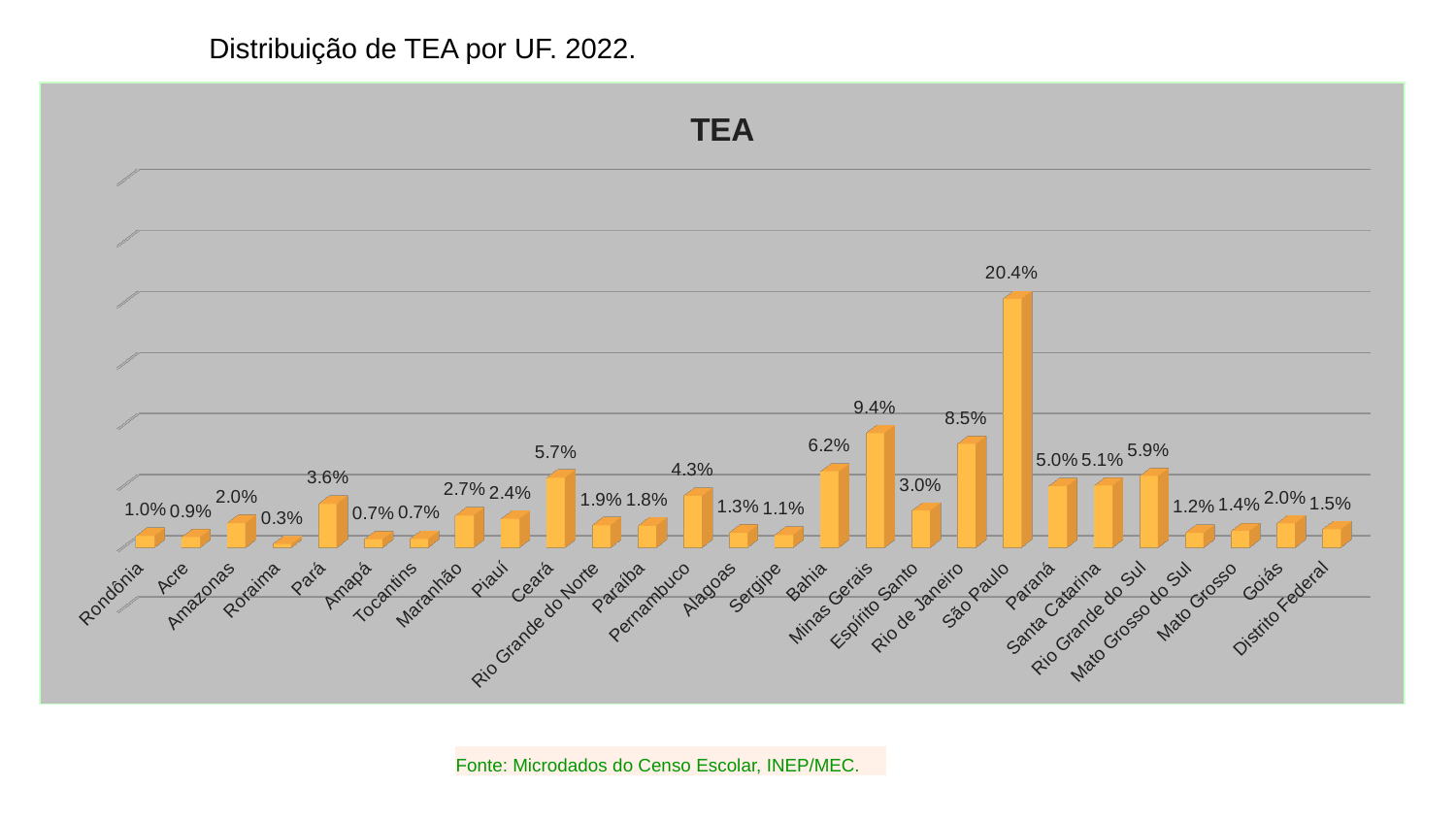
Which is larger, the value for Pernambuco or the value for Pará? Pernambuco What kind of chart is shown on the slide? Bar chart What is the difference between the values for Rio de Janeiro and Bahia? 2.3% What is the title shown inside the chart area? TEA What is the difference between the values for São Paulo and Minas Gerais? 11.0% What is the value for Ceará? 5.7% What is the value for São Paulo? 20.4% How many states (UFs) are shown on the chart? 27 What is the value for Minas Gerais? 9.4% Which state has the lowest value? Roraima What is the value for Roraima? 0.3% Which state has the highest value? São Paulo